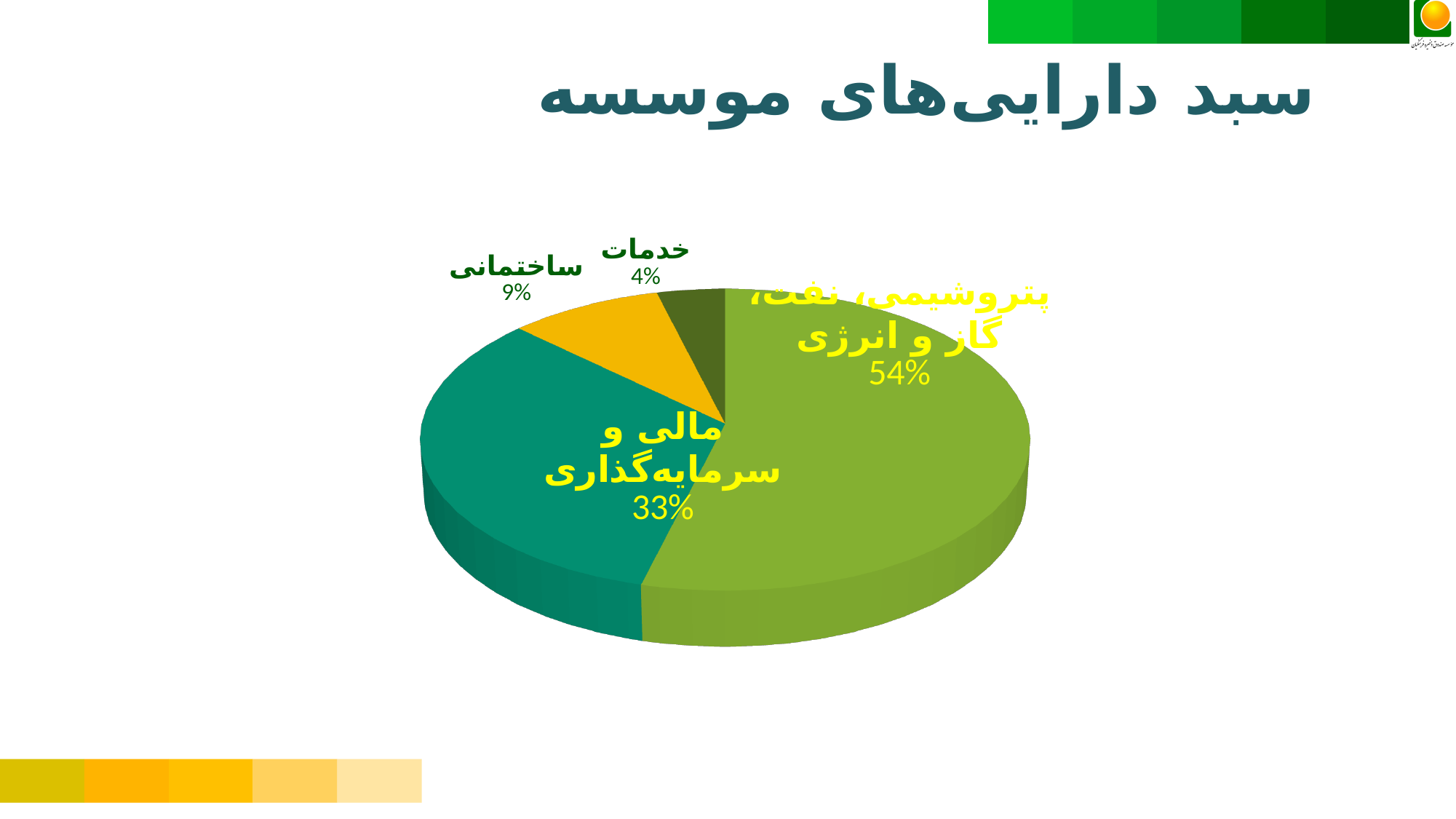
Which slice of the pie is the largest? پتروشیمی، نفت، گاز و انرژی What share of the pie does the مالی و سرمایه‌گذاری slice have? 33% How many slices does the pie chart have? 4 Which is larger, the ساختمانی slice or the خدمات slice? ساختمانی What kind of chart is shown on the slide? Pie chart What is the title of the chart slide? سبد دارایی‌های موسسه What share of the pie does the پتروشیمی، نفت، گاز و انرژی slice have? 54% What percentage is shown for the خدمات slice? 4% Which slice of the pie is the smallest? خدمات What is the difference in percentage points between the پتروشیمی، نفت، گاز و انرژی slice and the مالی و سرمایه‌گذاری slice? 21 percentage points What is the combined share of the ساختمانی and خدمات slices? 13% What percentage is shown for the ساختمانی slice? 9%